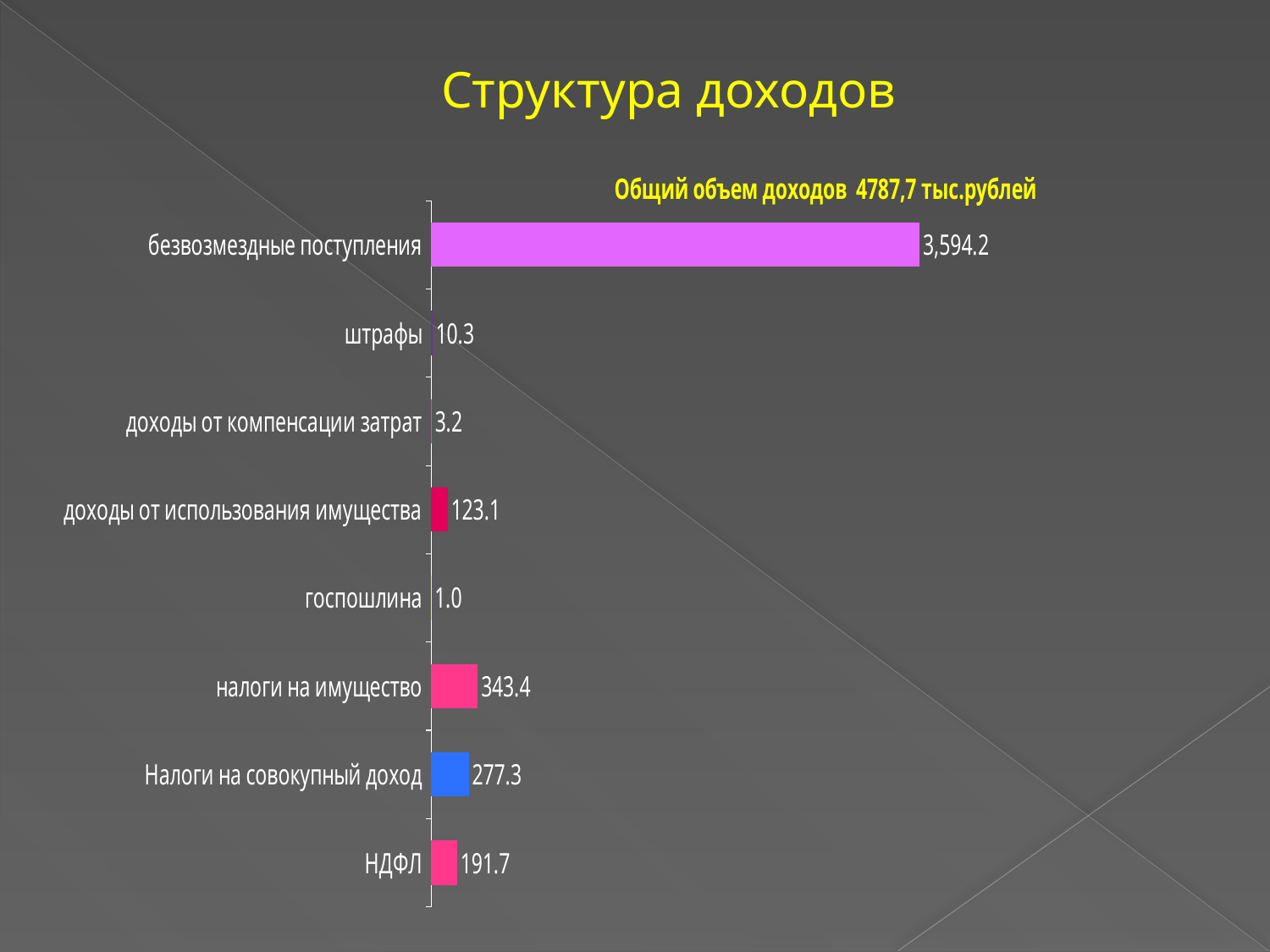
What kind of chart is shown on the slide? bar chart What is the value for НДФЛ? 191.7 What is the difference between штрафы and доходы от компенсации затрат? 7.1 What is the value for безвозмездные поступления? 3,594.2 Which category has the highest value? безвозмездные поступления What is the difference between налоги на имущество and Налоги на совокупный доход? 66.1 How many categories are shown in the chart? 8 Which is larger, Налоги на совокупный доход or НДФЛ? Налоги на совокупный доход What total income amount is stated above the chart? 4787,7 тыс.рублей What is the value for налоги на имущество? 343.4 Which category has the lowest value? госпошлина What is the value for доходы от использования имущества? 123.1